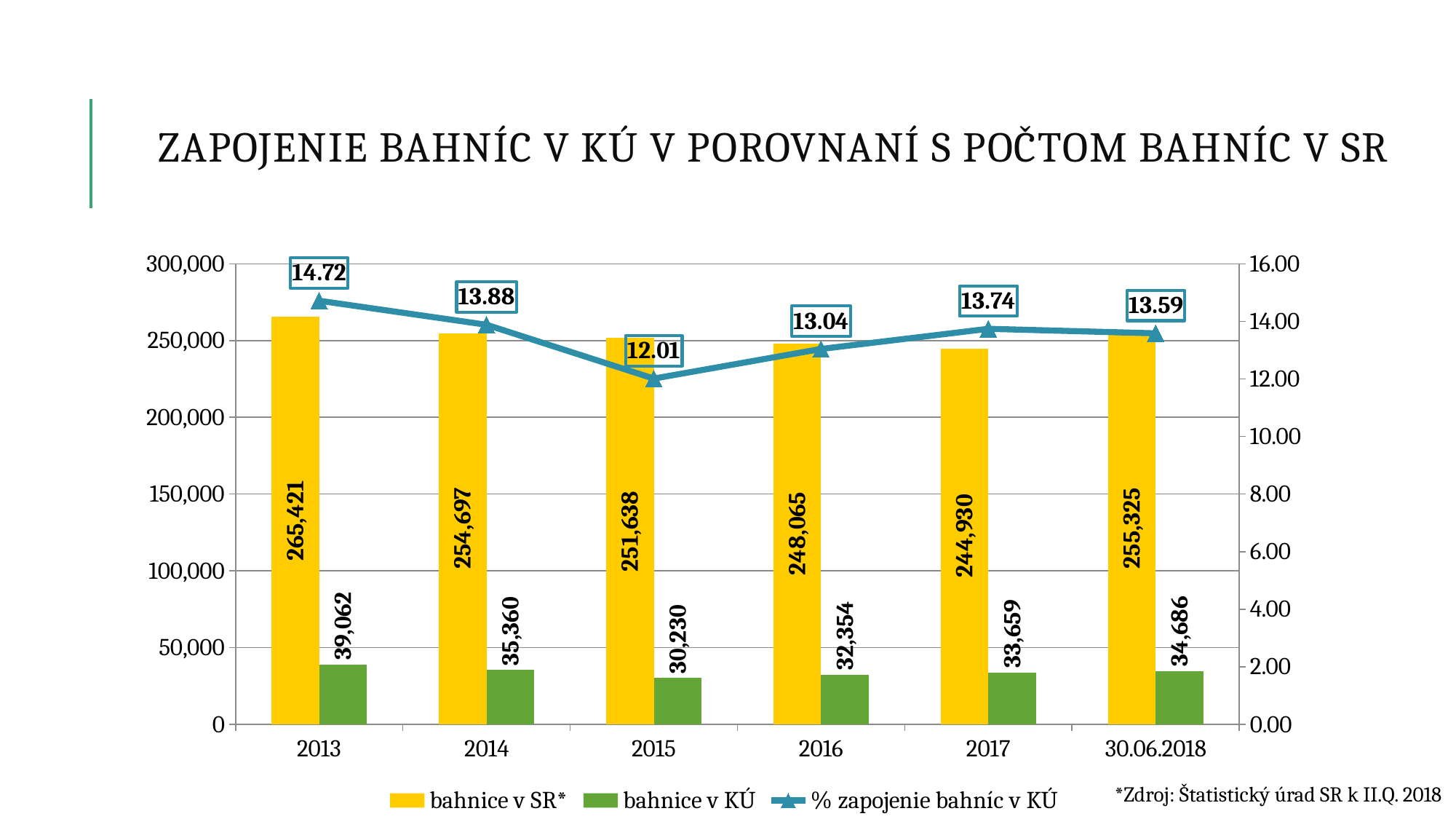
How many time periods are shown on the x axis? 6 How many series does the legend list? 3 Which is larger: bahnice v KÚ in 2016 or in 2017? 2017 In which year is bahnice v SR* the lowest? 2017 What is the value of bahnice v KÚ for 2015? 30,230 Does the % zapojenie bahníc v KÚ line rise or fall from 2013 to 2015? fall In which year is the % zapojenie bahníc v KÚ the lowest? 2015 What is the value of bahnice v SR* for 2013? 265,421 By how much did bahnice v KÚ decrease from 2013 to 2015? 8,832 In which year is bahnice v KÚ the highest? 2013 What is the % zapojenie bahníc v KÚ value for 30.06.2018? 13.59 What is the difference between bahnice v SR* and bahnice v KÚ in 2013? 226,359